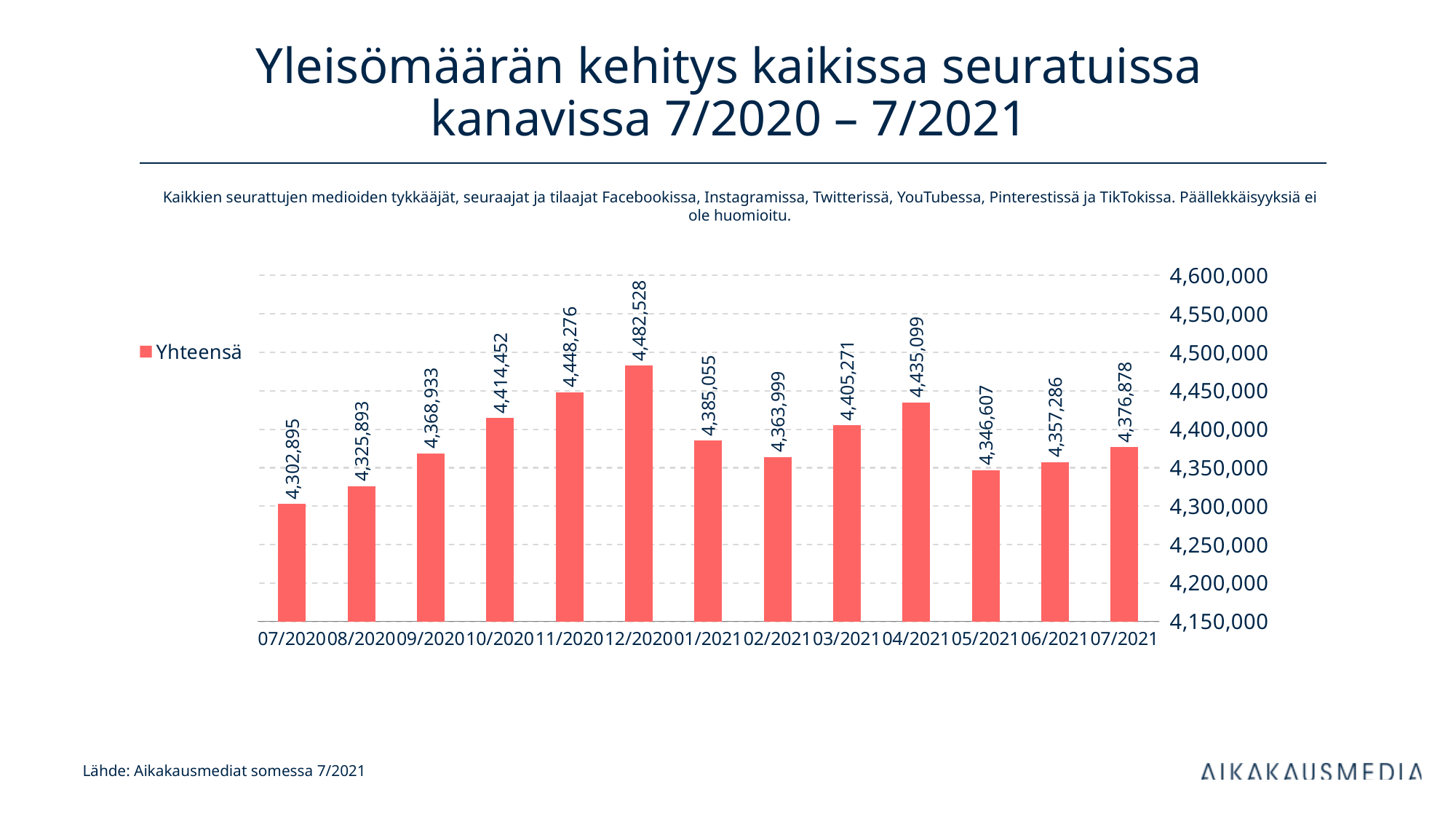
How many months are shown on the x axis? 13 What is the value for 04/2021? 4,435,099 What is the difference between the values for 12/2020 and 01/2021? 97,473 What is the value for 12/2020? 4,482,528 Which month has the lowest value? 07/2020 How many series does the legend list? 1 Is the value for 11/2020 greater or less than 4,400,000? greater What kind of chart is shown on the slide? bar chart What is the value for 07/2020? 4,302,895 Which is larger, the value for 03/2021 or the value for 05/2021? 03/2021 Which month has the highest value? 12/2020 What is the difference between the values for 07/2021 and 07/2020? 73,983